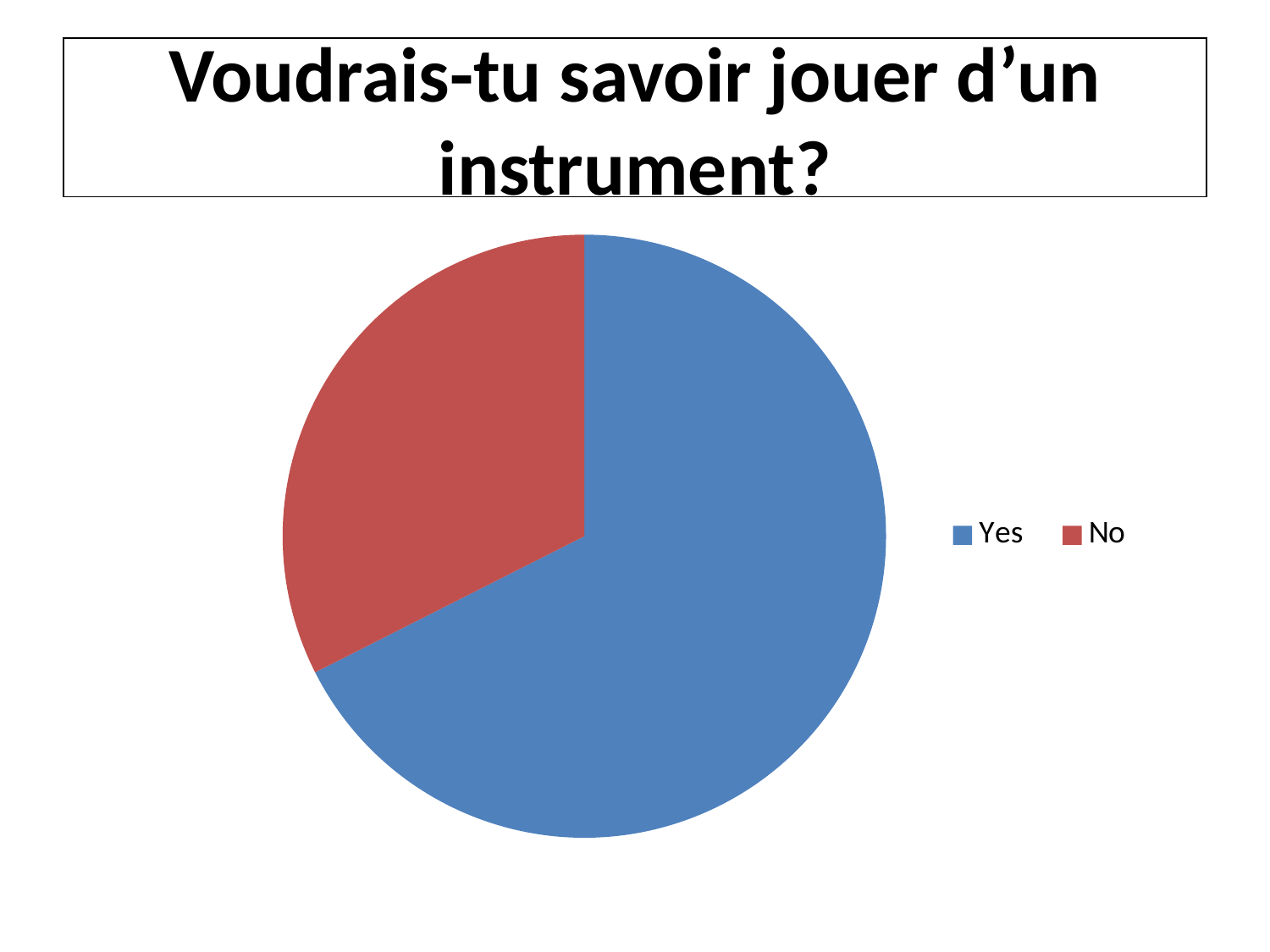
Which slice is larger, Yes or No? Yes What kind of chart is shown on the slide? pie chart How many slices does the pie chart have? 2 What colour is the Yes slice? blue What is the title of the slide above the chart? Voudrais-tu savoir jouer d’un instrument? Which slice is the smallest in the pie chart? No How many entries does the legend list? 2 Which slice is the largest in the pie chart? Yes